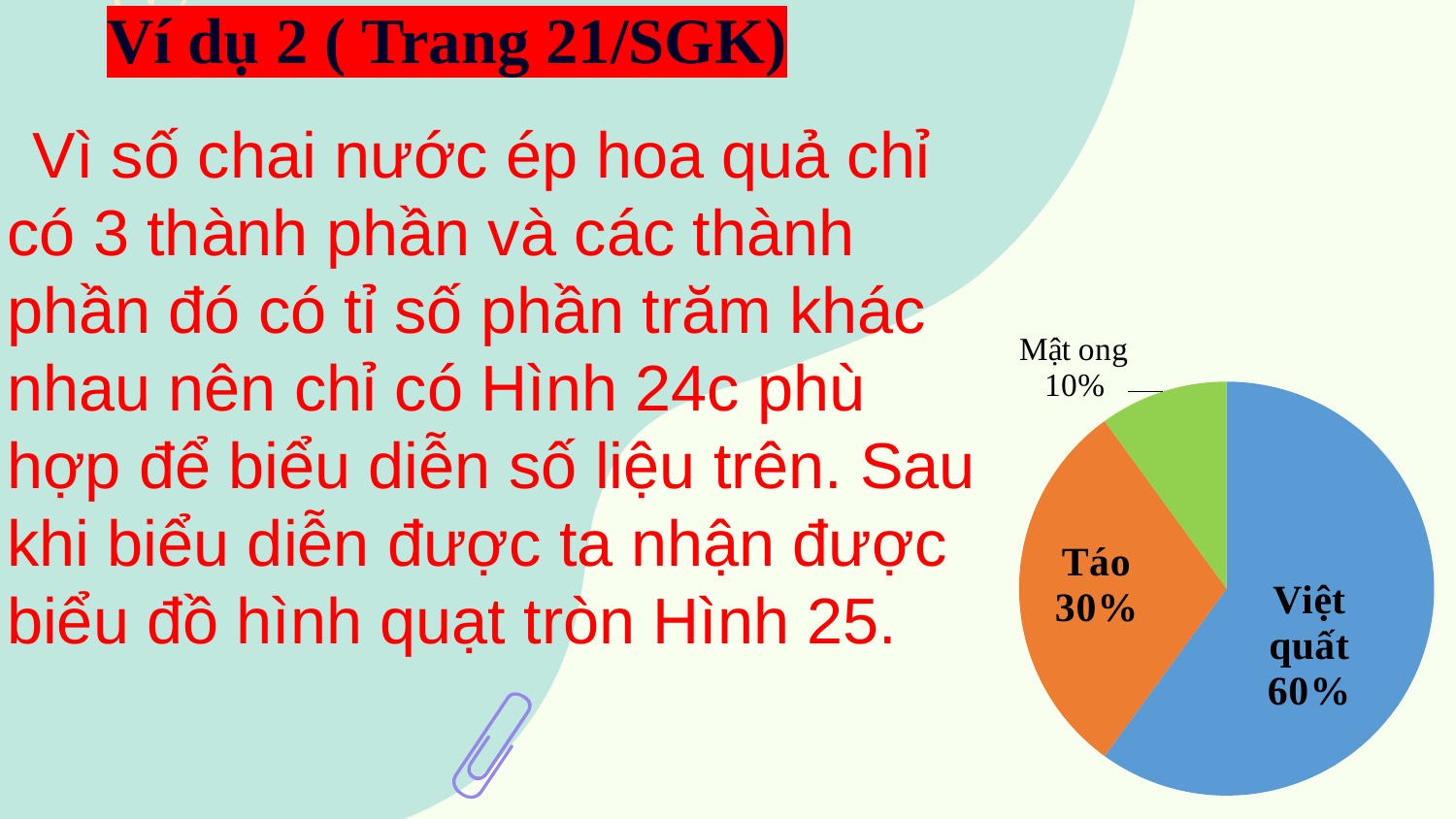
What is the difference in percentage between Việt quất and Táo? 30% What percentage does the Việt quất slice represent? 60% What is the difference in percentage between Táo and Mật ong? 20% What percentage does the Táo slice represent? 30% Which is larger, the Táo slice or the Mật ong slice? Táo Which slice of the pie chart is the smallest? Mật ong What colour is the Mật ong slice? green How many slices does the pie chart have? 3 What kind of chart is shown on the slide? pie chart What colour is the Việt quất slice? blue Which slice of the pie chart is the largest? Việt quất What percentage does the Mật ong slice represent? 10%